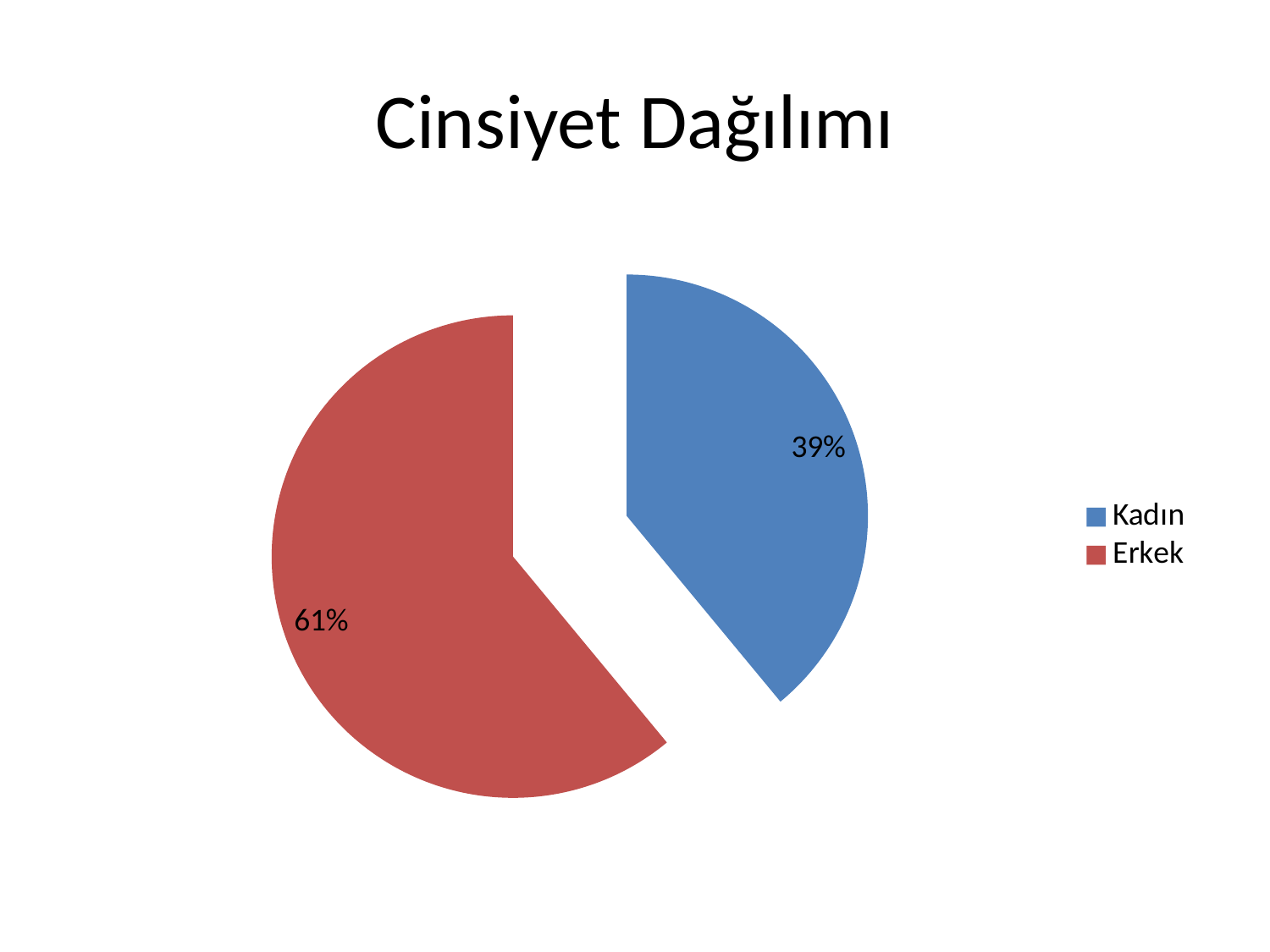
What is the share of the pie for Erkek? 61% What percentage of the pie is Erkek? 61% Which is larger, the share for Kadın or the share for Erkek? Erkek What kind of chart is shown on the slide? pie chart What is the difference in percentage points between the Erkek share and the Kadın share? 22 What is the title of the chart? Cinsiyet Dağılımı Which category has the smallest share of the pie? Kadın What colour is the Kadın slice? blue How many entries does the legend list? 2 Which category has the largest share of the pie? Erkek How many slices does the pie chart have? 2 What percentage of the pie is Kadın? 39%